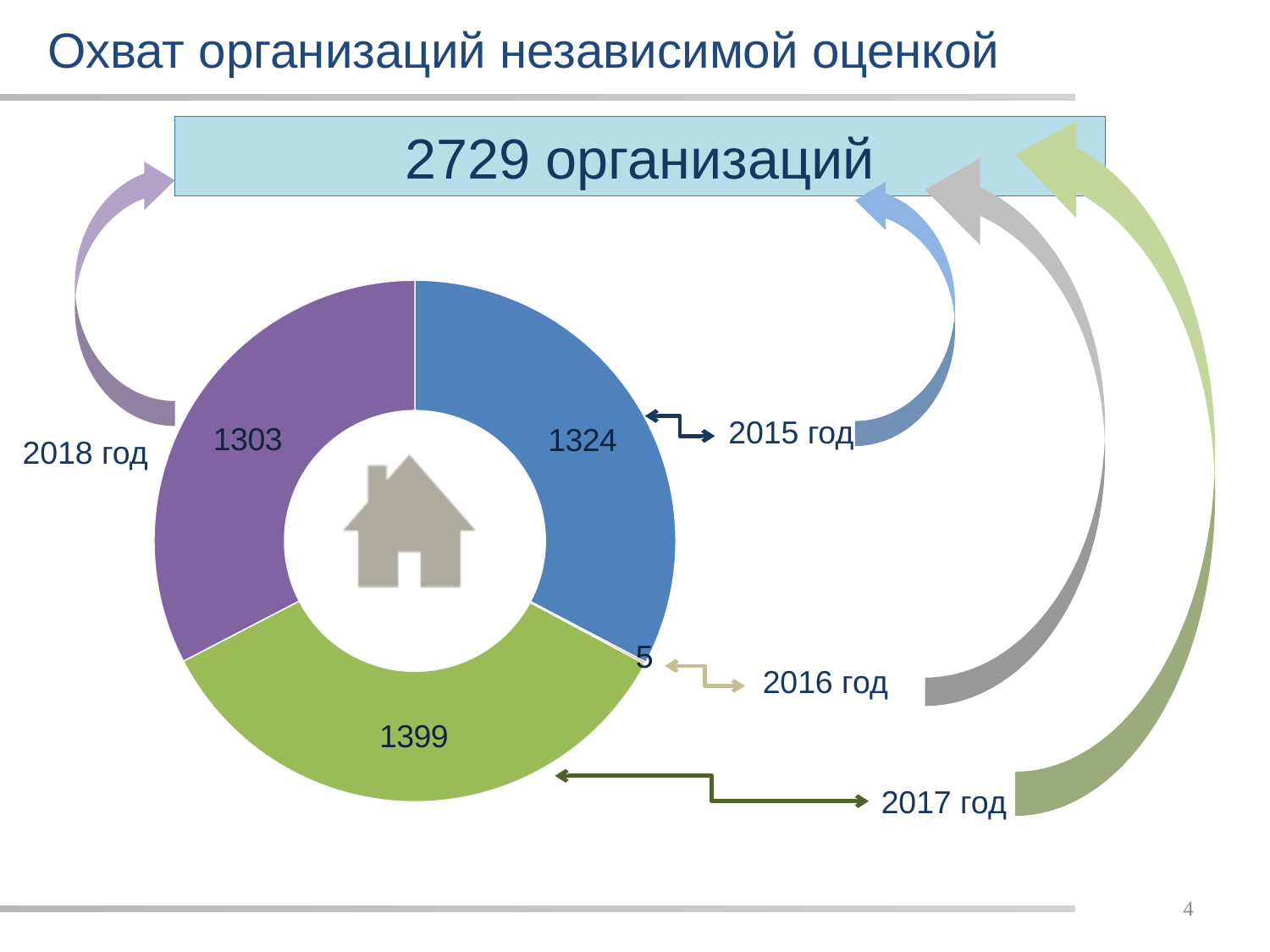
Which year has the smallest value in the doughnut chart? 2016 год Which year has the largest value in the doughnut chart? 2017 год Which is larger, the value for 2015 год or the value for 2018 год? 2015 год What kind of chart is shown on the slide? doughnut (pie) chart What number of organisations is stated in the box above the chart? 2729 организаций What value is shown for 2017 год in the doughnut chart? 1399 What is the difference between the values for 2015 год and 2018 год? 21 What value is shown for 2018 год in the doughnut chart? 1303 How many segments (years) does the doughnut chart have? 4 What value is shown for 2015 год in the doughnut chart? 1324 What is the difference between the values for 2017 год and 2015 год? 75 What value is shown for 2016 год in the doughnut chart? 5